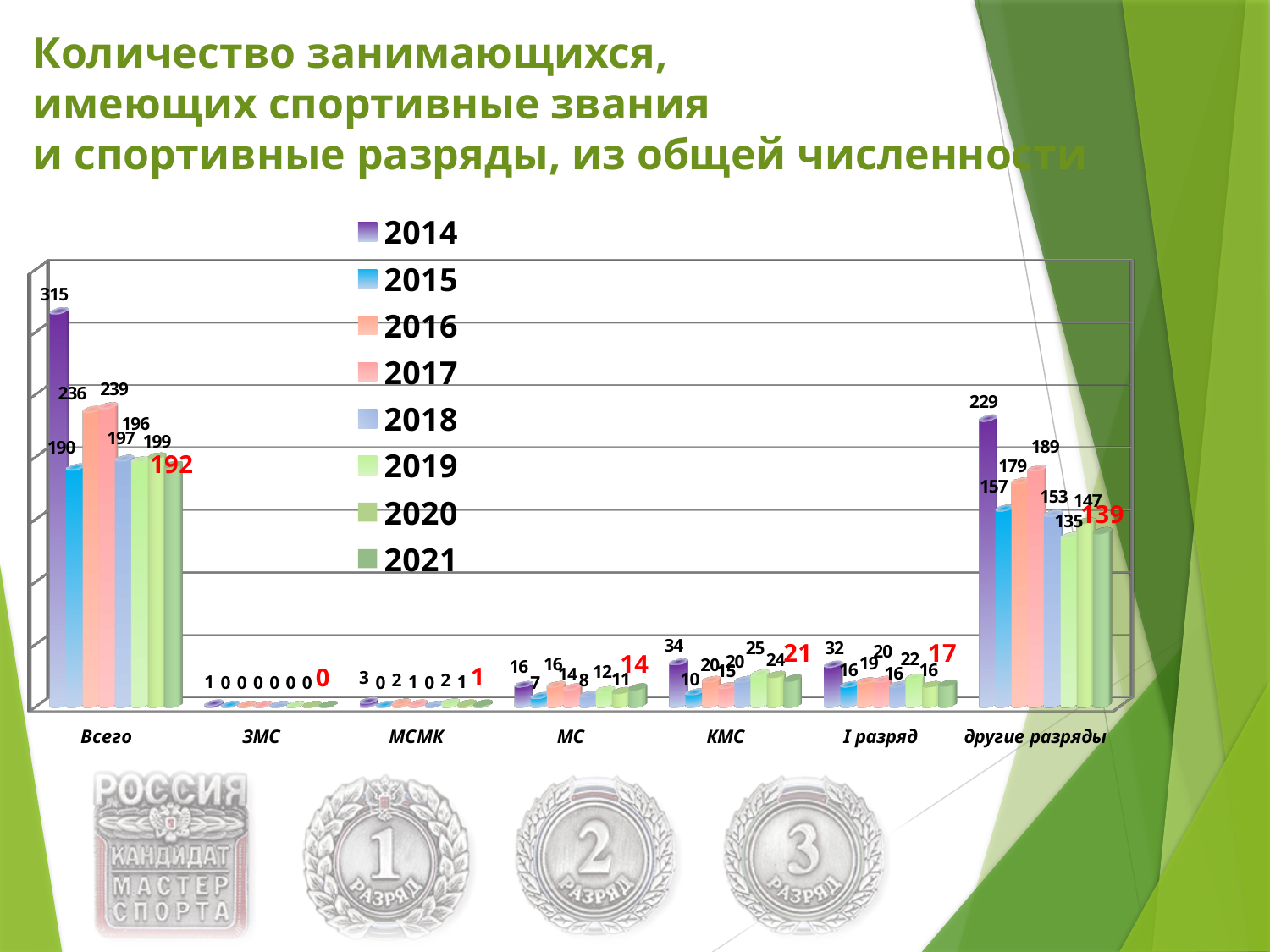
What is the value for 2015 in the МС category? 7 What is the first entry in the chart legend? 2014 How many categories are shown on the x axis? 7 What kind of chart is shown on the slide? bar chart What is the value for 2014 in the Всего category? 315 What is the difference between the 2014 and 2015 values in the Всего category? 125 Which year has the highest value in the Всего category? 2014 Which year has the lowest value in the другие разряды category? 2019 How many series does the legend list? 8 Which is larger for 2014: the КМС value or the I разряд value? КМС What is the value for 2021 in the другие разряды category? 139 What is the value for 2021 in the КМС category? 21